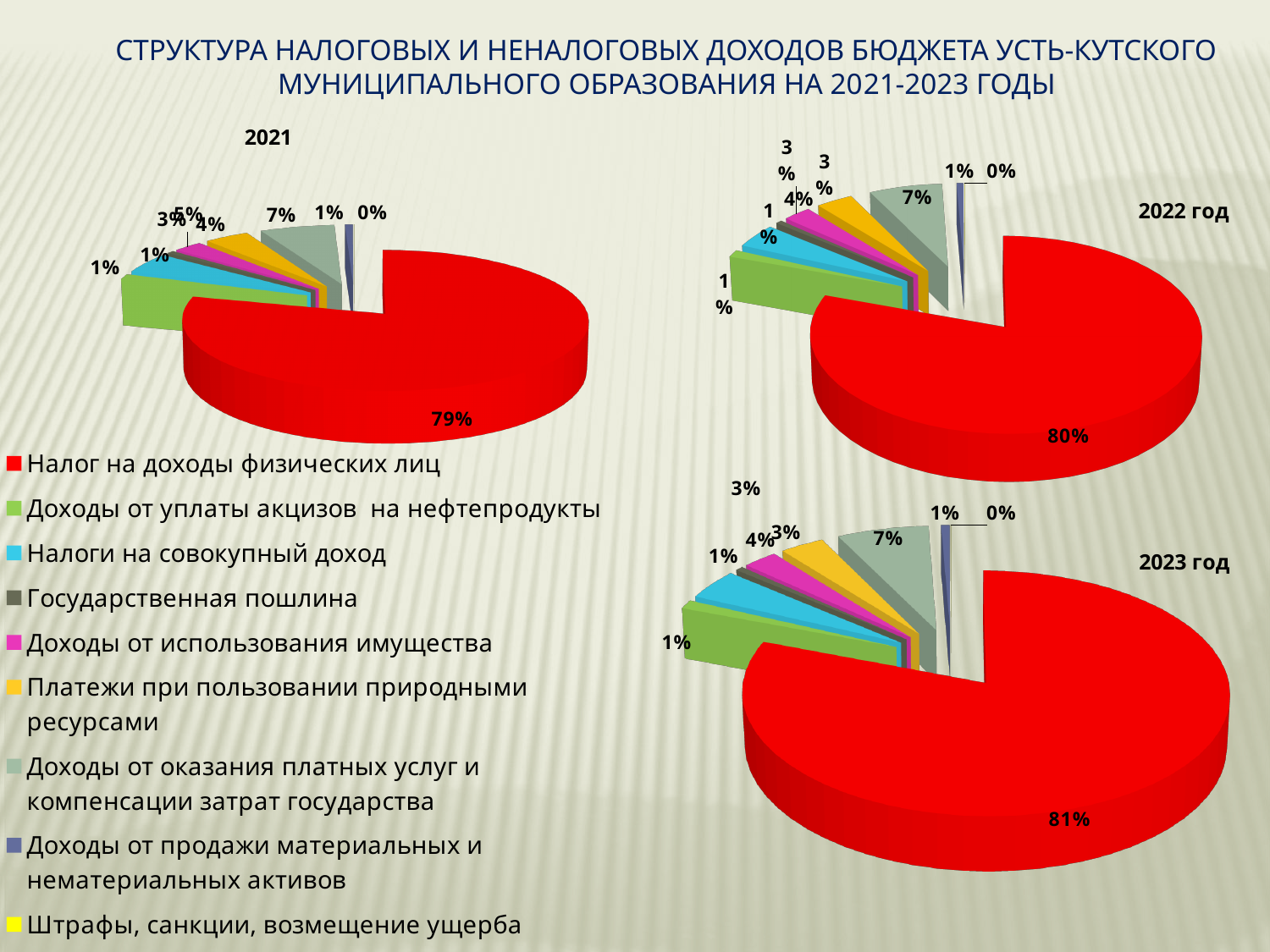
In the 2022 год pie chart, what share does Налог на доходы физических лиц have? 80% In the 2022 год pie chart, what share does Доходы от оказания платных услуг и компенсации затрат государства have? 7% In the 2021 pie chart, what share does Штрафы, санкции, возмещение ущерба have? 0% By how many percentage points does the share of Налог на доходы физических лиц in the 2023 год chart exceed its share in the 2021 chart? 2% Which colour represents Налог на доходы физических лиц in the legend? Red How many categories does the legend list? 9 In the 2023 год pie chart, which category has the largest slice? Налог на доходы физических лиц Does the share of Налог на доходы физических лиц rise or fall from the 2021 chart to the 2023 год chart? Rise What kind of charts are shown on the slide? Pie charts How many pie charts are on the slide? 3